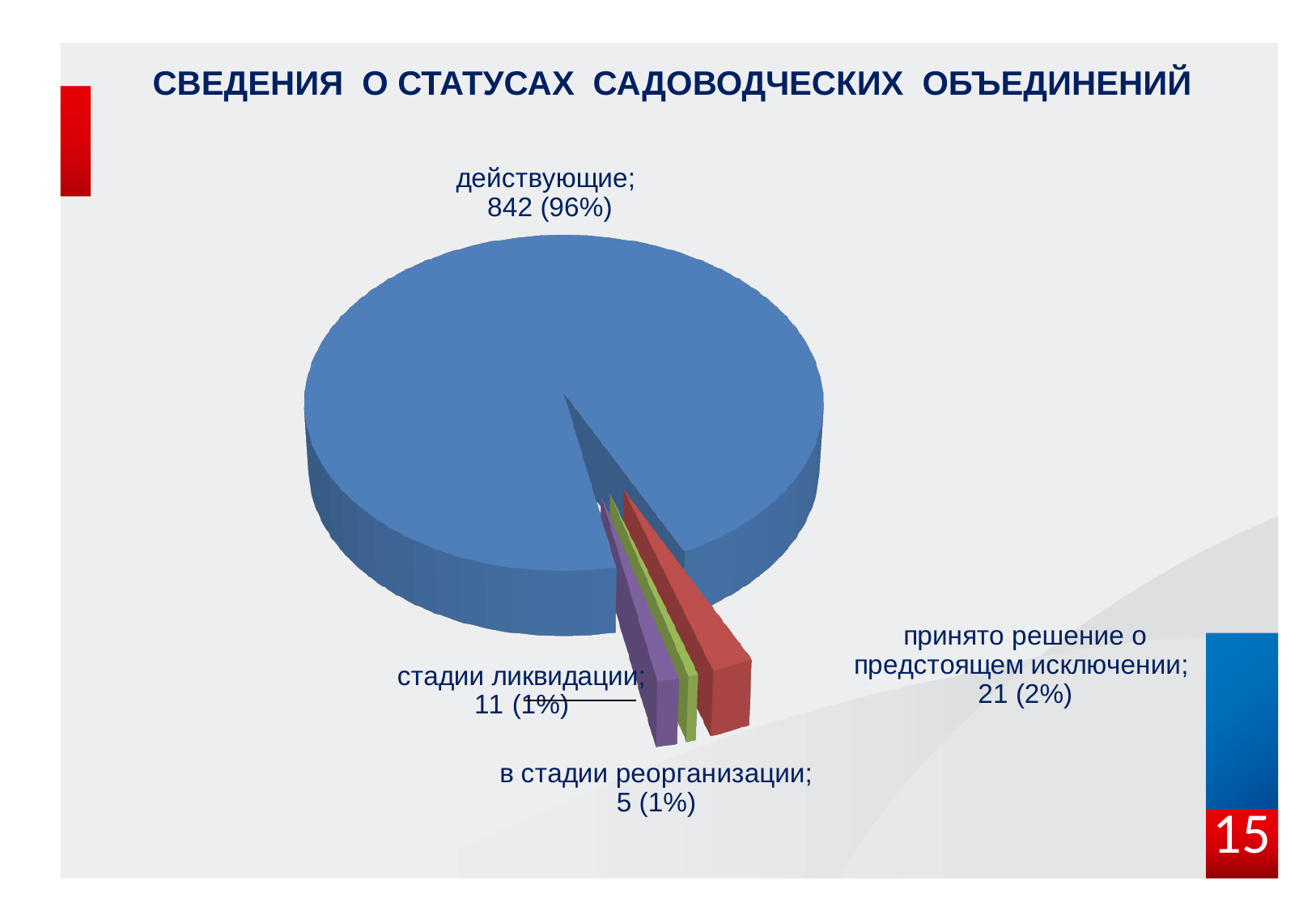
What is the value for "стадии ликвидации"? 11 (1%) What is the difference between the counts for "принято решение о предстоящем исключении" and "стадии ликвидации"? 10 What kind of chart is shown on the slide? pie chart What is the value for "принято решение о предстоящем исключении"? 21 (2%) How many slices does the pie chart have? 4 What is the value for "в стадии реорганизации"? 5 (1%) What is the value for "действующие"? 842 (96%) What share of the pie does "действующие" represent? 96% What is the title of the slide? СВЕДЕНИЯ О СТАТУСАХ САДОВОДЧЕСКИХ ОБЪЕДИНЕНИЙ Which is larger: "стадии ликвидации" or "в стадии реорганизации"? стадии ликвидации Which category has the largest slice? действующие Which category has the smallest slice? в стадии реорганизации